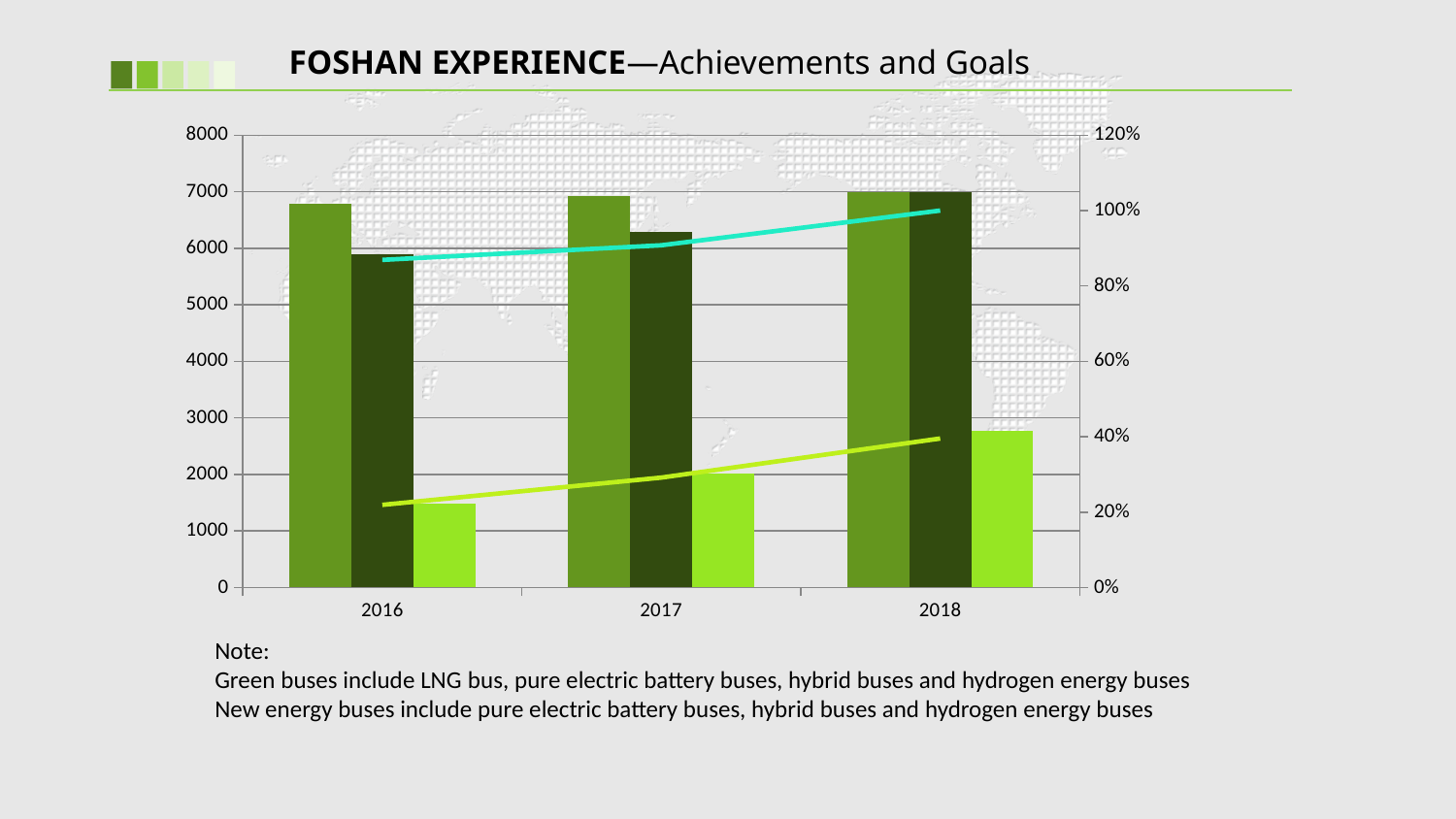
How many years are shown on the x axis of the chart? 3 Is the value of the dark green bar for 2016 greater or less than 5000? greater Do the light green bars rise or fall from 2016 to 2018? rise For 2016, which is larger: the medium green bar or the dark green bar? the medium green bar What kind of chart is shown on the slide? combination bar and line chart What is the highest value shown on the left vertical axis of the chart? 8000 Do the dark green bars rise or fall from 2016 to 2018? rise Is the value of the light green bar for 2018 greater or less than 2000? greater Is the value of the light green bar for 2016 greater or less than 2000? less In which year is the light green bar the highest? 2018 Which years are shown on the x axis of the chart? 2016, 2017, 2018